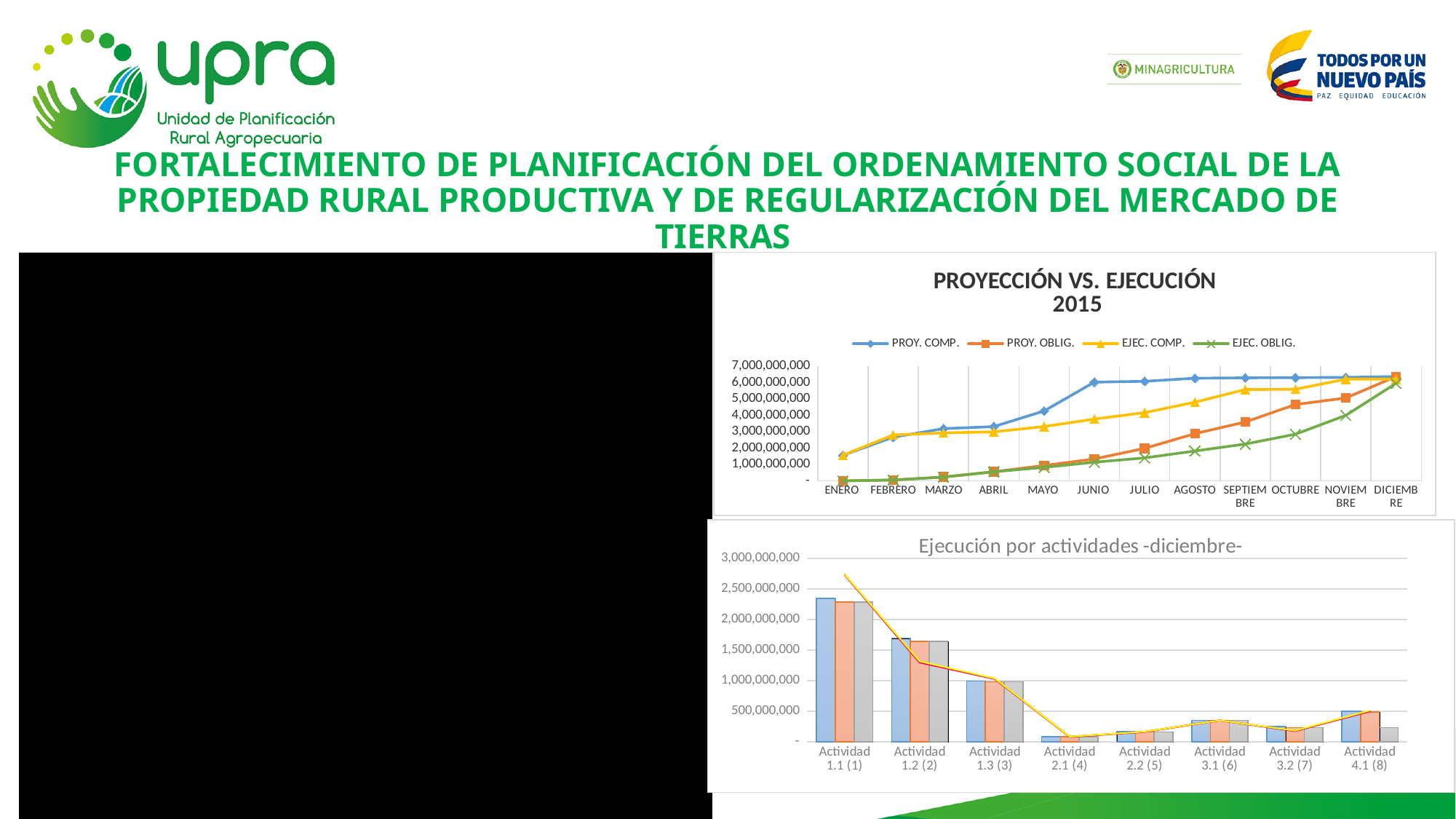
In the 'Ejecución por actividades -diciembre-' chart, which activity has the tallest bars? Actividad 1.1 (1) What type of chart is the 'PROYECCIÓN VS. EJECUCIÓN 2015' chart? Line chart In the 'Ejecución por actividades -diciembre-' chart, are the bars for Actividad 2.1 (4) greater or less than 500,000,000? less In the 'PROYECCIÓN VS. EJECUCIÓN 2015' chart, which series is higher in JUNIO, PROY. COMP. or EJEC. OBLIG.? PROY. COMP. In the 'PROYECCIÓN VS. EJECUCIÓN 2015' chart, is the EJEC. OBLIG. value for JULIO greater or less than 2,000,000,000? less How many months are shown on the x axis of the 'PROYECCIÓN VS. EJECUCIÓN 2015' chart? 12 In the 'PROYECCIÓN VS. EJECUCIÓN 2015' chart, is the PROY. COMP. value for JUNIO greater or less than 5,000,000,000? greater What type of chart is the 'Ejecución por actividades -diciembre-' chart? Combination bar and line chart In the 'Ejecución por actividades -diciembre-' chart, which has taller bars, Actividad 1.2 (2) or Actividad 1.3 (3)? Actividad 1.2 (2) How many series does the legend of the 'PROYECCIÓN VS. EJECUCIÓN 2015' chart list? 4 In the 'PROYECCIÓN VS. EJECUCIÓN 2015' chart, does the EJEC. OBLIG. series rise or fall from ENERO to DICIEMBRE? Rise How many activities are shown on the x axis of the 'Ejecución por actividades -diciembre-' chart? 8